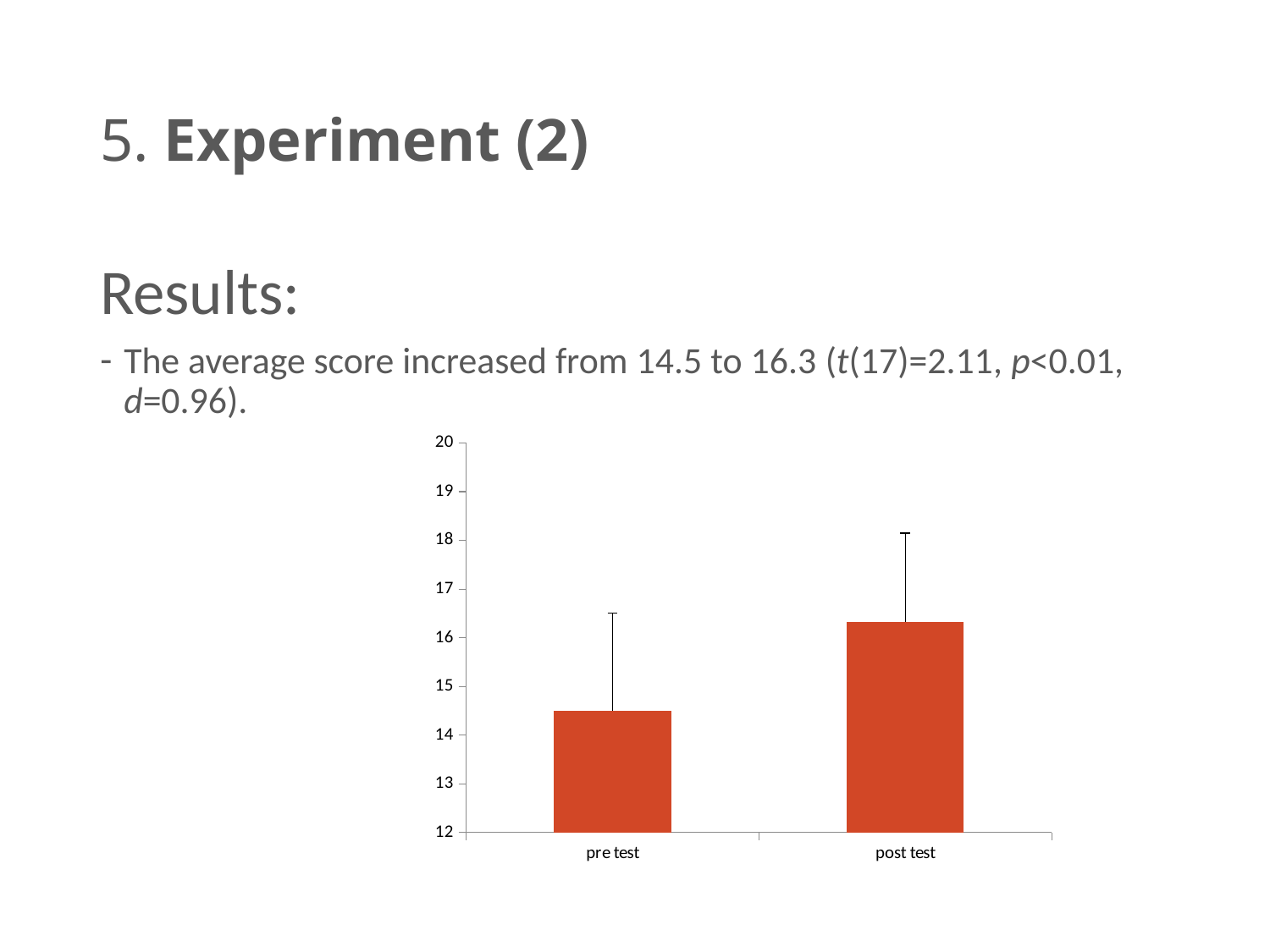
Which category has the highest value in the chart? post test Is the value for post test greater or less than 17? less Do the values rise or fall from pre test to post test? rise Which category has the lowest value in the chart? pre test What is the difference between the post test and pre test average scores? 1.8 What kind of chart is shown on the slide? bar chart What is the average score for post test shown in the chart? 16.3 Is the value for pre test greater or less than 15? less Which is larger, the value for pre test or the value for post test? post test How many categories are plotted in the chart? 2 What is the average score for pre test shown in the chart? 14.5 What is the lowest value shown on the vertical axis of the chart? 12